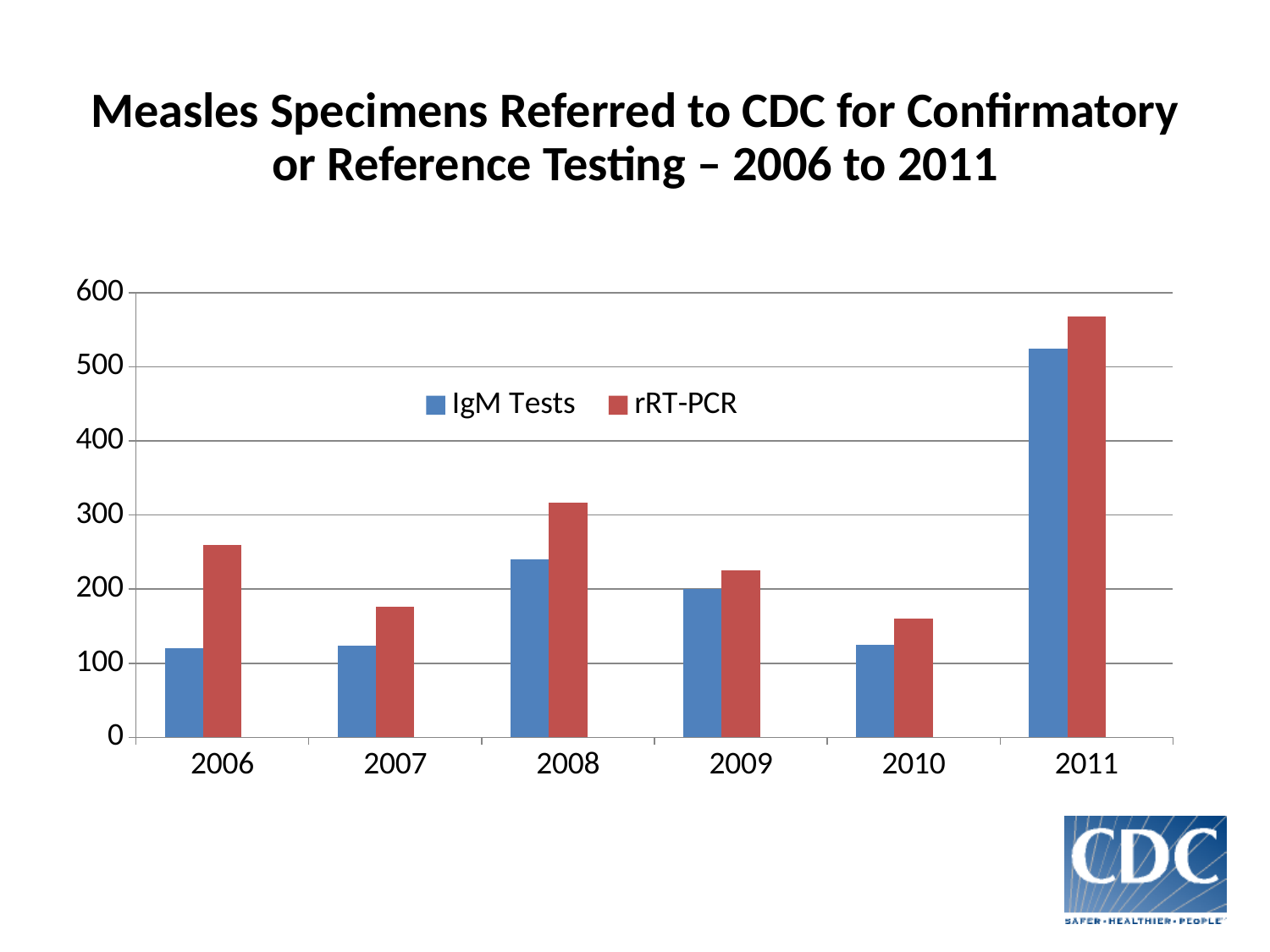
Which year has the highest IgM Tests value? 2011 Is the rRT-PCR value for 2008 greater or less than 300? greater Which series is shown in red? rRT-PCR Is the IgM Tests value for 2011 greater or less than 500? greater Is the rRT-PCR value for 2006 greater or less than 200? greater How many years are shown on the x axis? 6 In 2006, which series has the larger value, IgM Tests or rRT-PCR? rRT-PCR How many series does the legend list? 2 Which is larger, the rRT-PCR value for 2006 or the rRT-PCR value for 2008? 2008 Which year has the highest rRT-PCR value? 2011 What kind of chart is shown on the slide? bar chart